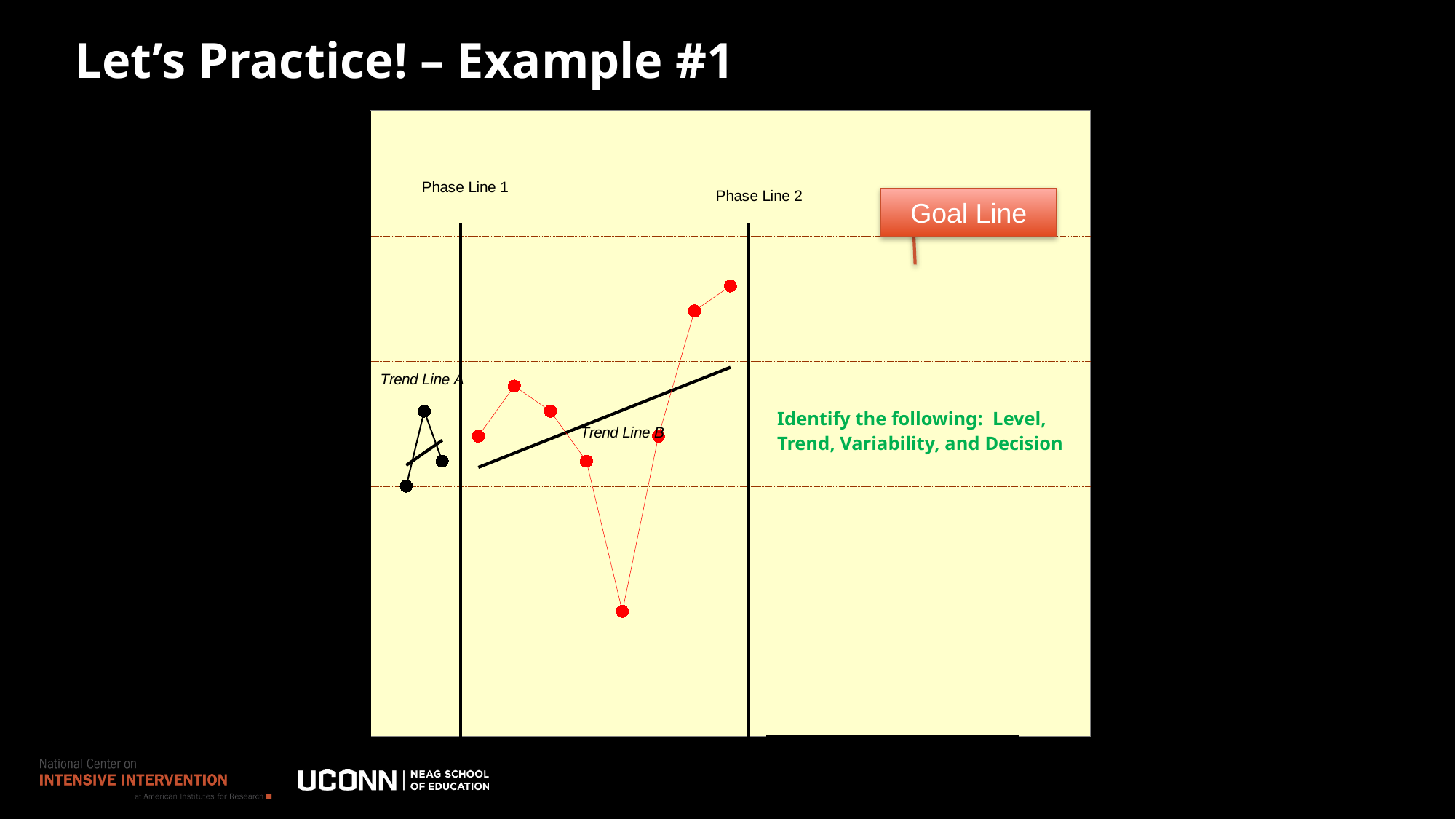
How many phase lines are drawn on the chart? 2 What label is shown in the orange callout box at the top right of the chart? Goal Line Does Trend Line A slope upward or downward from left to right? Upward What kind of chart is shown on the slide? Line chart How many red data points are plotted between Phase Line 1 and Phase Line 2? 8 Which of the red data points between the phase lines is the highest? The last (eighth) point How many black data points are plotted to the left of Phase Line 1? 3 Is the last red data point higher or lower than the first red data point? Higher Is the highest red data point above or below the Goal Line? Below Which of the red data points between the phase lines is the lowest? The fifth point Does Trend Line B slope upward or downward from left to right? Upward What is the label of the trend line drawn through the red data points? Trend Line B